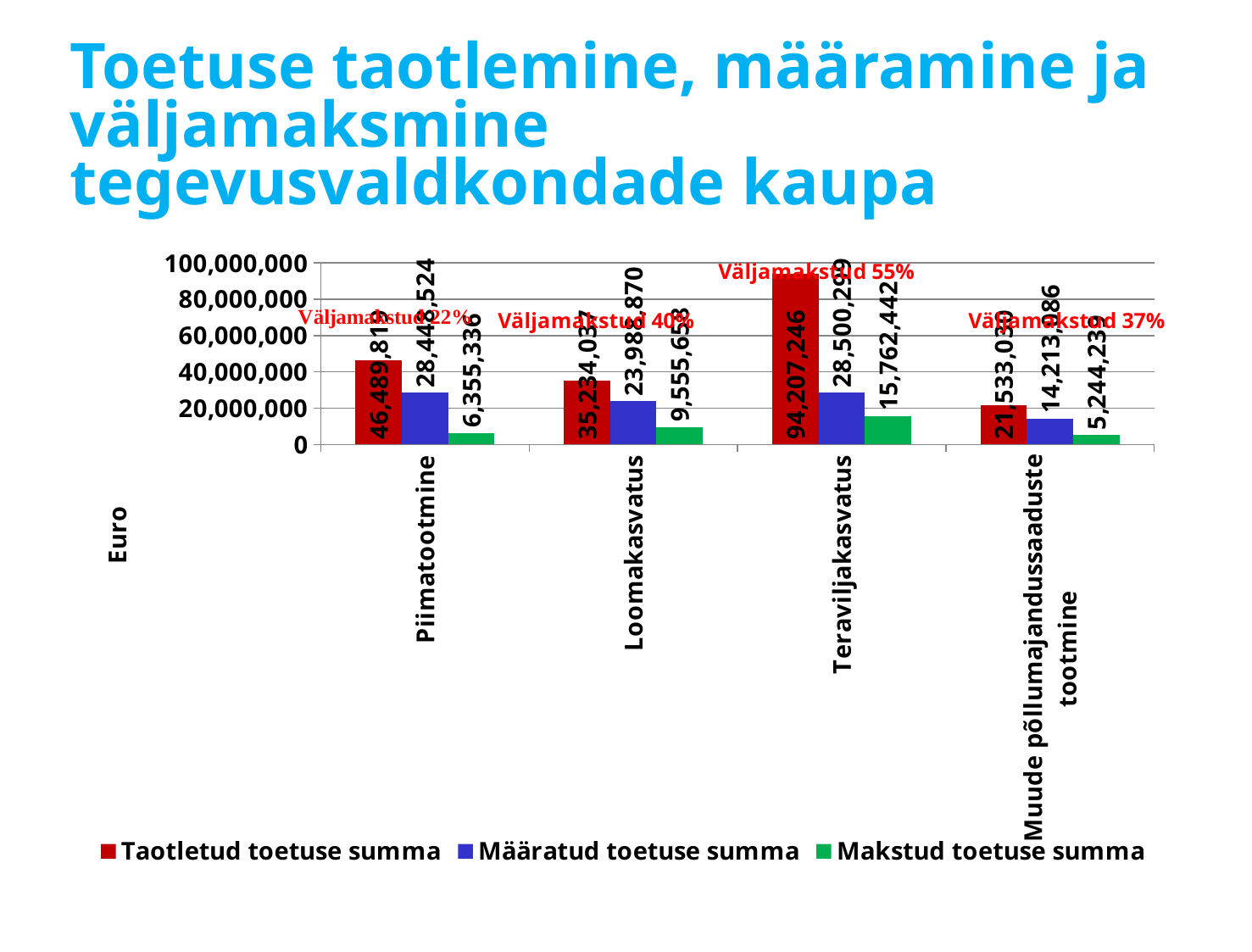
Which has the larger Makstud toetuse summa, Loomakasvatus or Piimatootmine? Loomakasvatus Is the Taotletud toetuse summa for Piimatootmine greater or less than 40,000,000? greater Which category has the lowest Makstud toetuse summa? Muude põllumajandussaaduste tootmine How many series does the legend list? 3 What is the Taotletud toetuse summa value for Teraviljakasvatus? 94,207,246 How many categories are shown on the x axis? 4 Which category has the highest Taotletud toetuse summa? Teraviljakasvatus What is the Makstud toetuse summa value for Piimatootmine? 6,355,336 What is the difference between the Taotletud toetuse summa and the Makstud toetuse summa for Teraviljakasvatus? 78,444,804 What percentage is given in the 'Väljamakstud' annotation above Teraviljakasvatus? 55% What is the Määratud toetuse summa value for Loomakasvatus? 23,988,870 What is the Makstud toetuse summa value for Teraviljakasvatus? 15,762,442